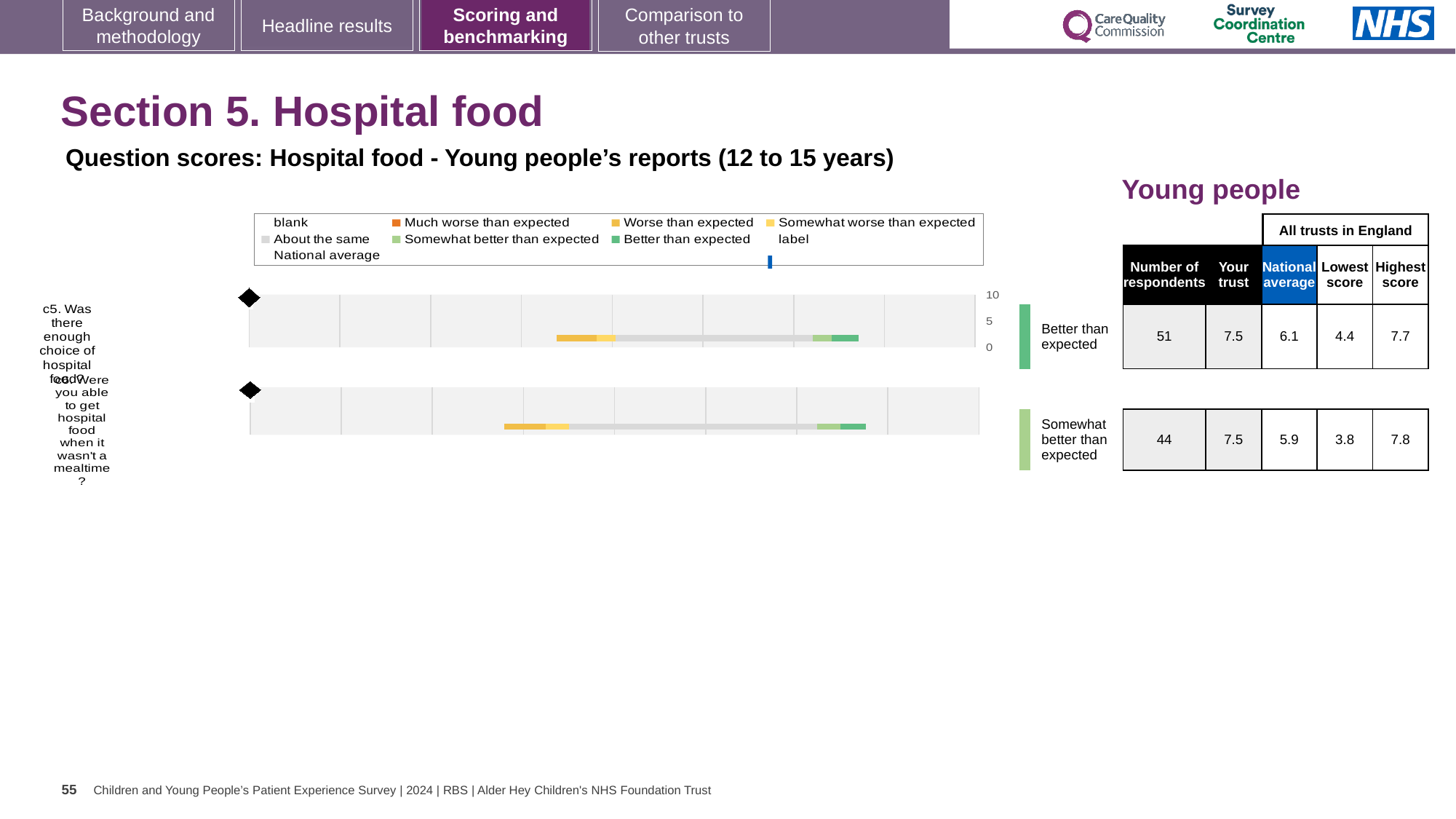
According to the table beside the chart, what is the lowest score for c5 (enough choice of hospital food)? 4.4 What kind of chart is shown on the slide? Bar chart For c6, which is larger: the 'Your trust' score or the national average? Your trust By how much does the 'Your trust' score for c5 exceed the national average for c5? 1.4 What colour does the legend use for 'Better than expected'? Green Which benchmark category is shown for c6 (getting hospital food when it wasn't a mealtime)? Somewhat better than expected According to the table beside the chart, what is the 'Your trust' score for c6 (getting hospital food when it wasn't a mealtime)? 7.5 According to the table beside the chart, what is the national average for c5 (enough choice of hospital food)? 6.1 According to the table beside the chart, what is the highest score for c6 (getting hospital food when it wasn't a mealtime)? 7.8 How many questions (bars) are plotted in the chart? 2 Which question is plotted in the top row of the chart? c5. Was there enough choice of hospital food? According to the table beside the chart, how many respondents answered c5 (enough choice of hospital food)? 51